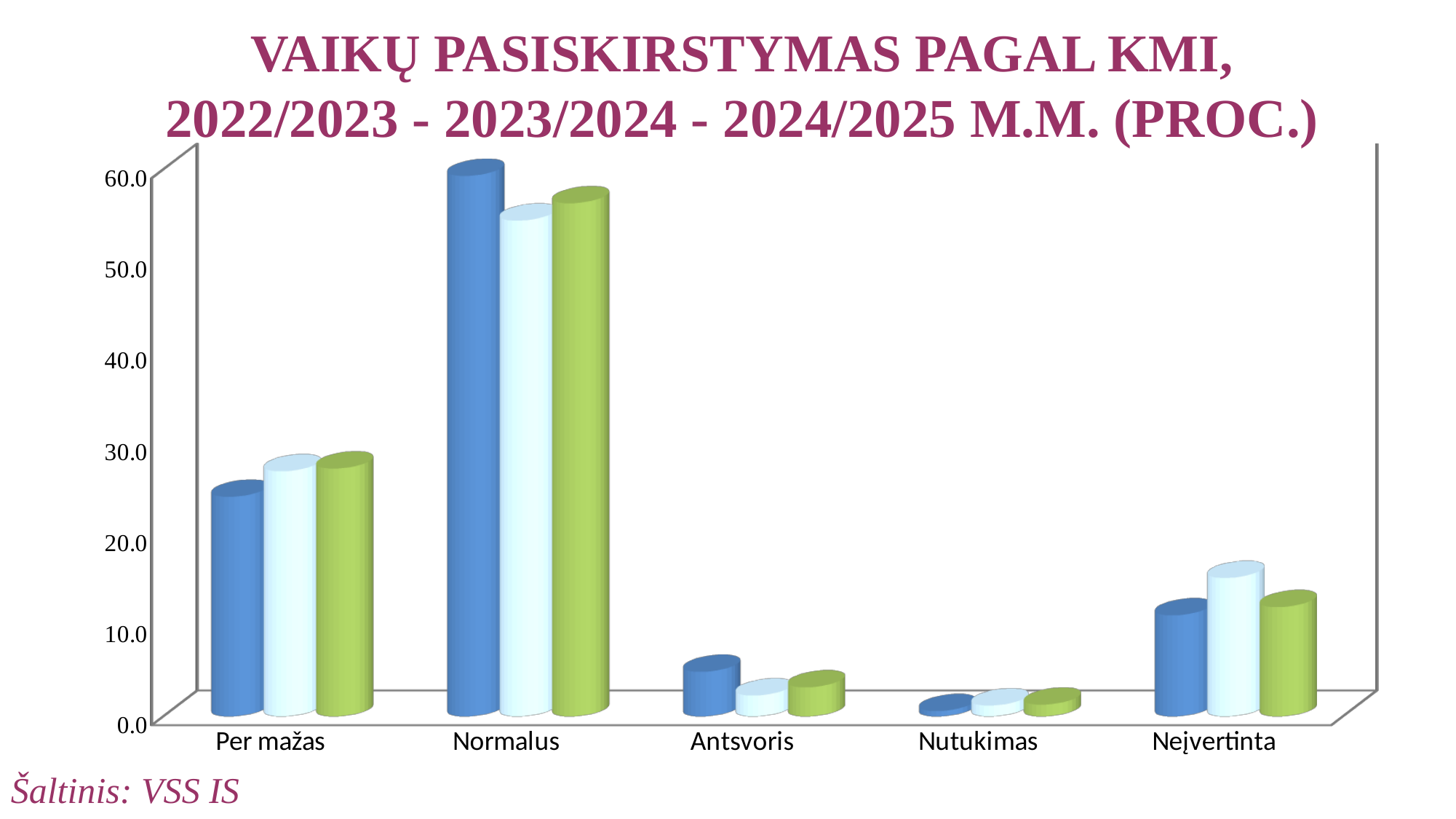
Are the values for Per mažas greater or less than 20? greater Which category has the highest values in the chart? Normalus What is the source cited below the chart? VSS IS How many bars are plotted for each category in the chart? 3 Which category has the lowest values in the chart? Nutukimas Is the value of the tallest bar for Neįvertinta greater or less than 20? less Is the value of the tallest bar for Normalus greater or less than 50? greater Which category has larger values, Per mažas or Neįvertinta? Per mažas What kind of chart is shown on the slide? bar chart How many categories are shown on the x axis of the chart? 5